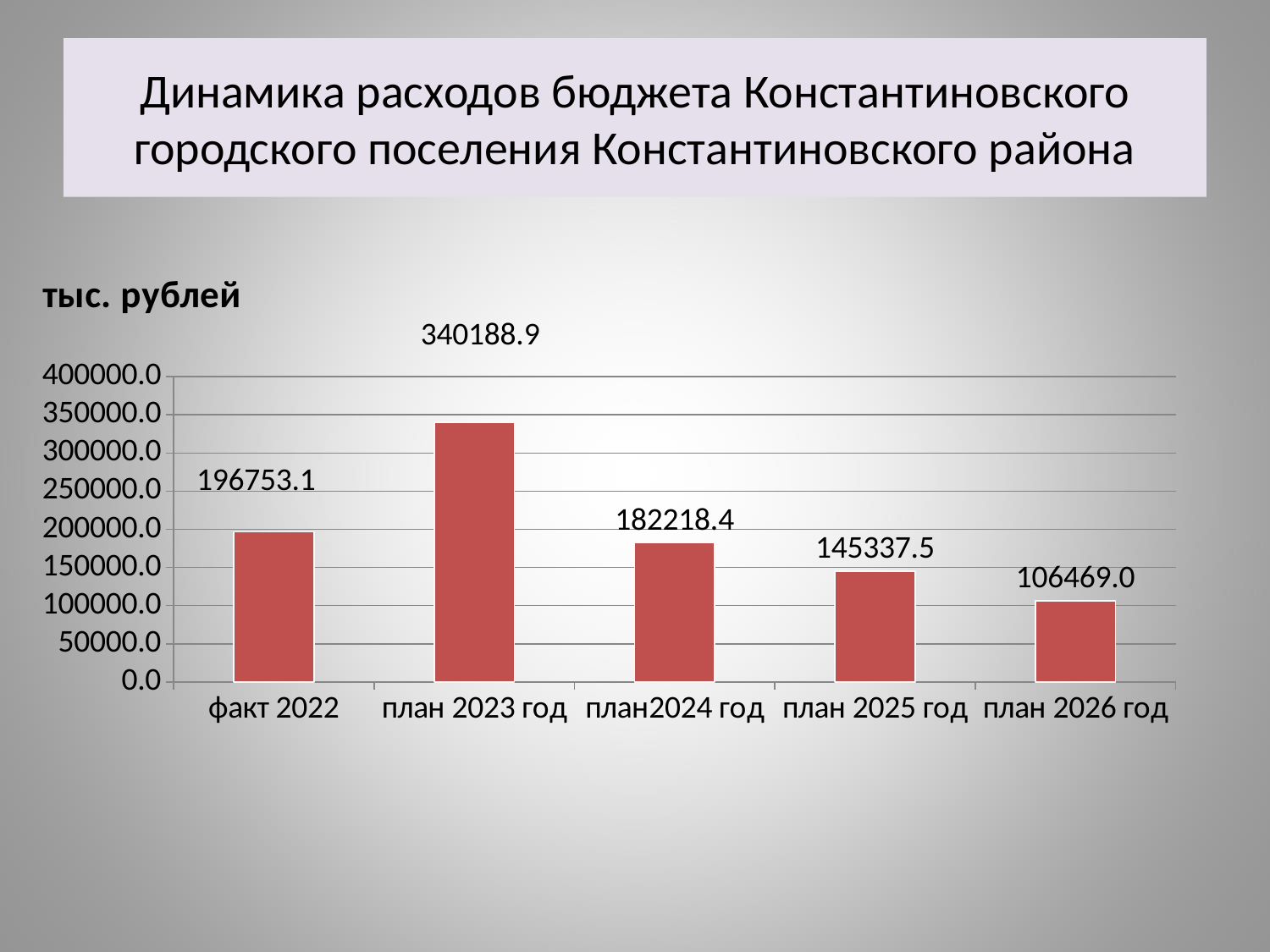
What is the value for план 2026 год? 106469.0 What is the value for план 2023 год? 340188.9 Which category has the highest value? план 2023 год What kind of chart is shown on the slide? bar chart Which is larger, the value for факт 2022 or the value for план2024 год? факт 2022 What is the difference between the values for план 2023 год and факт 2022? 143435.8 Is the value for план 2025 год greater or less than 150000.0? less What is the value for факт 2022? 196753.1 What is the difference between the values for план 2025 год and план 2026 год? 38868.5 Which category has the lowest value? план 2026 год From план 2023 год to план 2026 год, do the values rise or fall? fall How many categories are shown on the x axis? 5